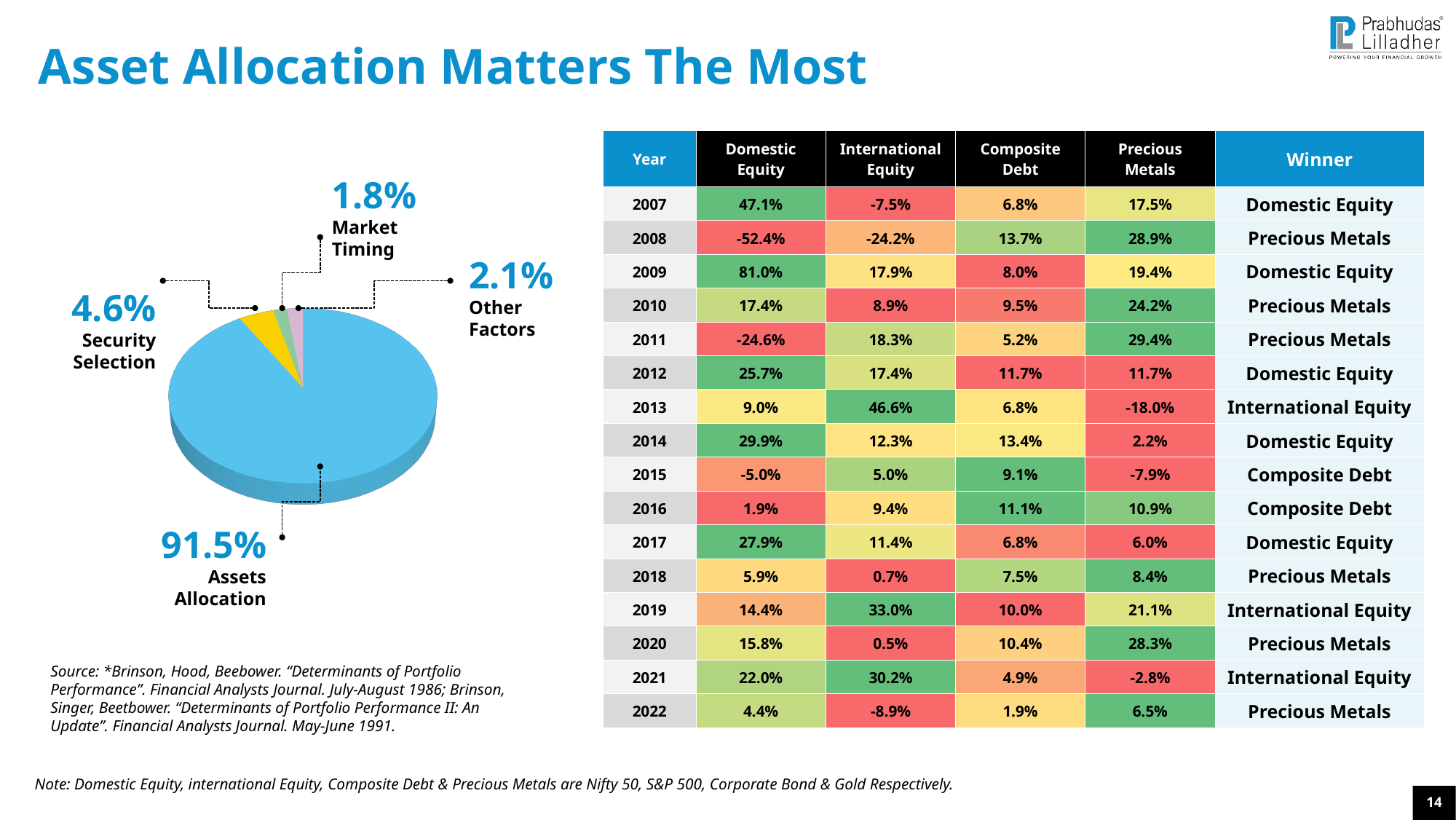
What colour is the Assets Allocation slice in the pie chart? Blue In the pie chart, how much larger is the Other Factors share than the Market Timing share? 0.3 percentage points Which slice of the pie chart is the smallest? Market Timing In the pie chart, which is larger: Security Selection or Other Factors? Security Selection In the pie chart, what share of the pie does Other Factors represent? 2.1% In the pie chart, what is the difference between the Assets Allocation share and the Security Selection share? 86.9 percentage points What kind of chart is shown on the left of the slide? Pie chart Which slice of the pie chart is the largest? Assets Allocation In the pie chart, what percentage is shown for Market Timing? 1.8% In the pie chart, what percentage is shown for Security Selection? 4.6% How many slices does the pie chart have? 4 In the pie chart, what percentage is shown for Assets Allocation? 91.5%